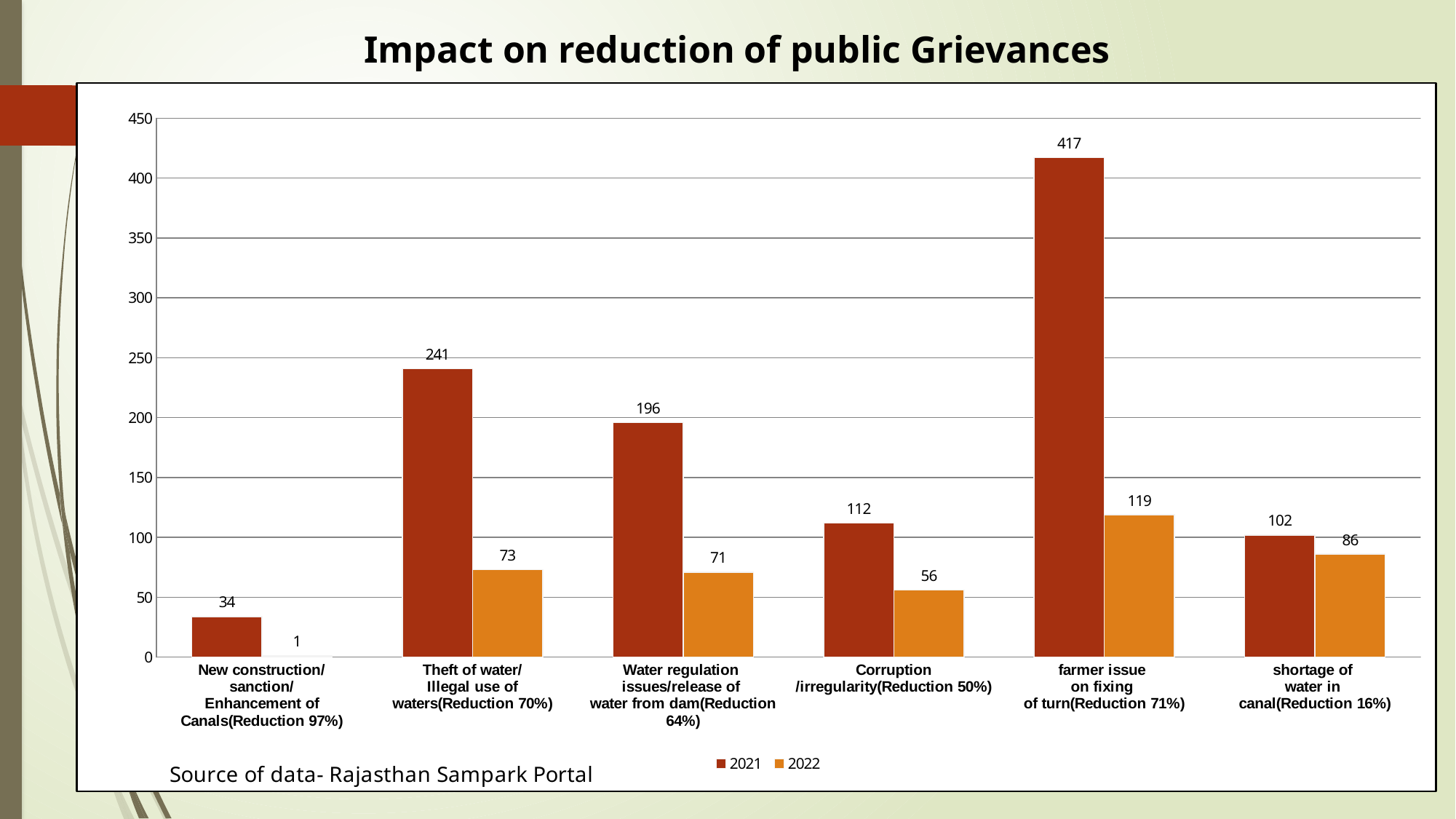
How many categories are shown on the x axis? 6 What kind of chart is shown on the slide? bar chart Which is larger: the 2022 value for 'farmer issue on fixing of turn' or the 2021 value for 'shortage of water in canal'? 2022 value for farmer issue on fixing of turn How many series does the legend list? 2 What is the difference between the 2021 and 2022 values for 'Corruption/irregularity'? 56 Which category has the lowest 2022 value? New construction/sanction/Enhancement of Canals What is the title of the chart? Impact on reduction of public Grievances What is the 2022 value for 'Theft of water/Illegal use of waters'? 73 What is the 2021 value for 'farmer issue on fixing of turn'? 417 Which category has the highest 2021 value? farmer issue on fixing of turn What is the 2022 value for 'New construction/sanction/Enhancement of Canals'? 1 Is the 2021 value for 'Water regulation issues/release of water from dam' greater or less than 150? greater